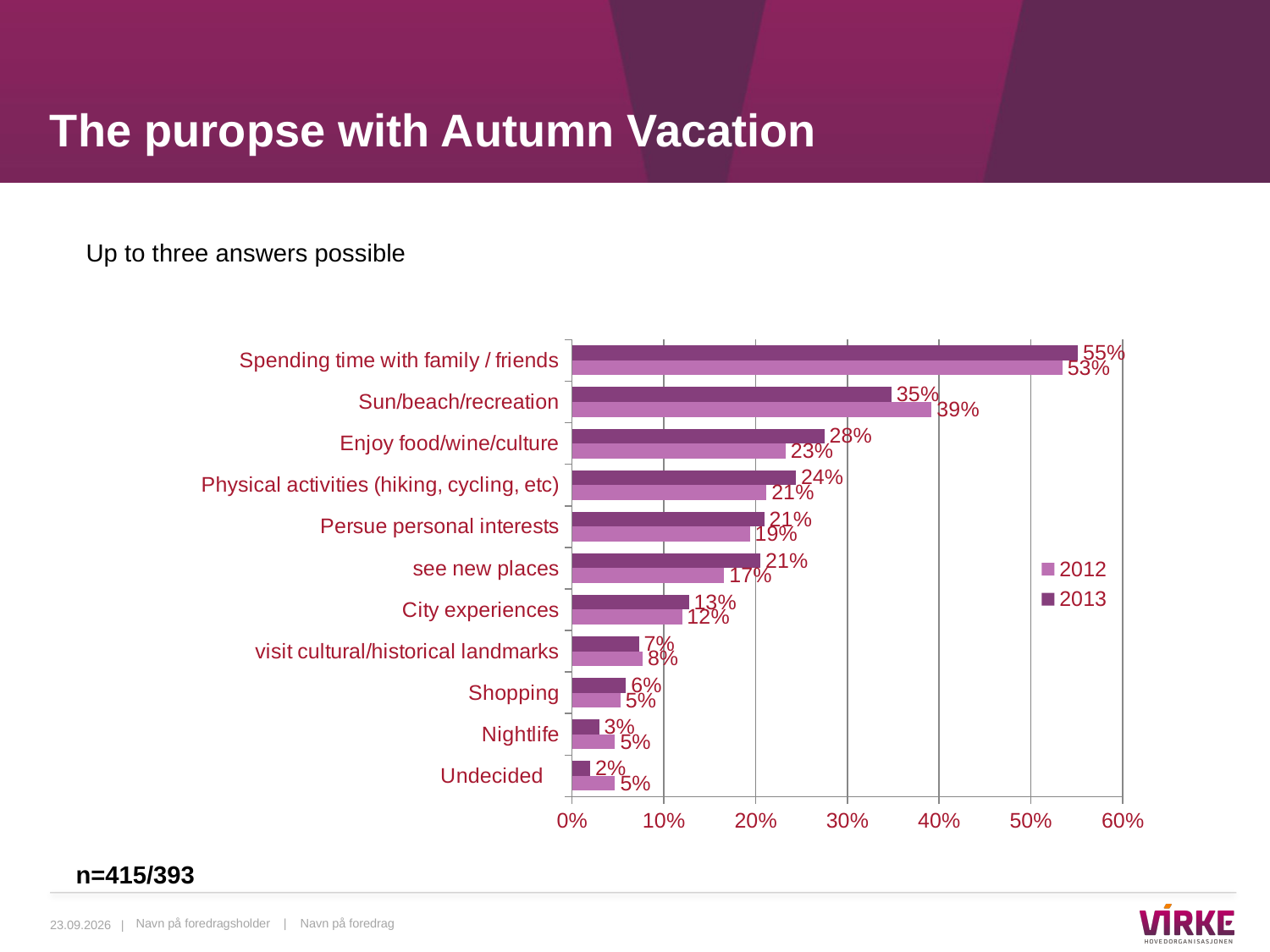
Which category has the lowest 2013 value? Undecided What is the 2013 value for Enjoy food/wine/culture? 28% What is the 2012 value for Sun/beach/recreation? 39% Which series does the legend list first? 2012 How many series does the legend list? 2 Which is larger for Nightlife, the 2012 value or the 2013 value? 2012 What kind of chart is shown on the slide? Bar chart What is the 2012 value for see new places? 17% What is the difference between the 2012 and 2013 values for Sun/beach/recreation? 4% Which category has the highest 2013 value? Spending time with family / friends How many categories are shown in the chart? 11 What is the 2013 value for Spending time with family / friends? 55%